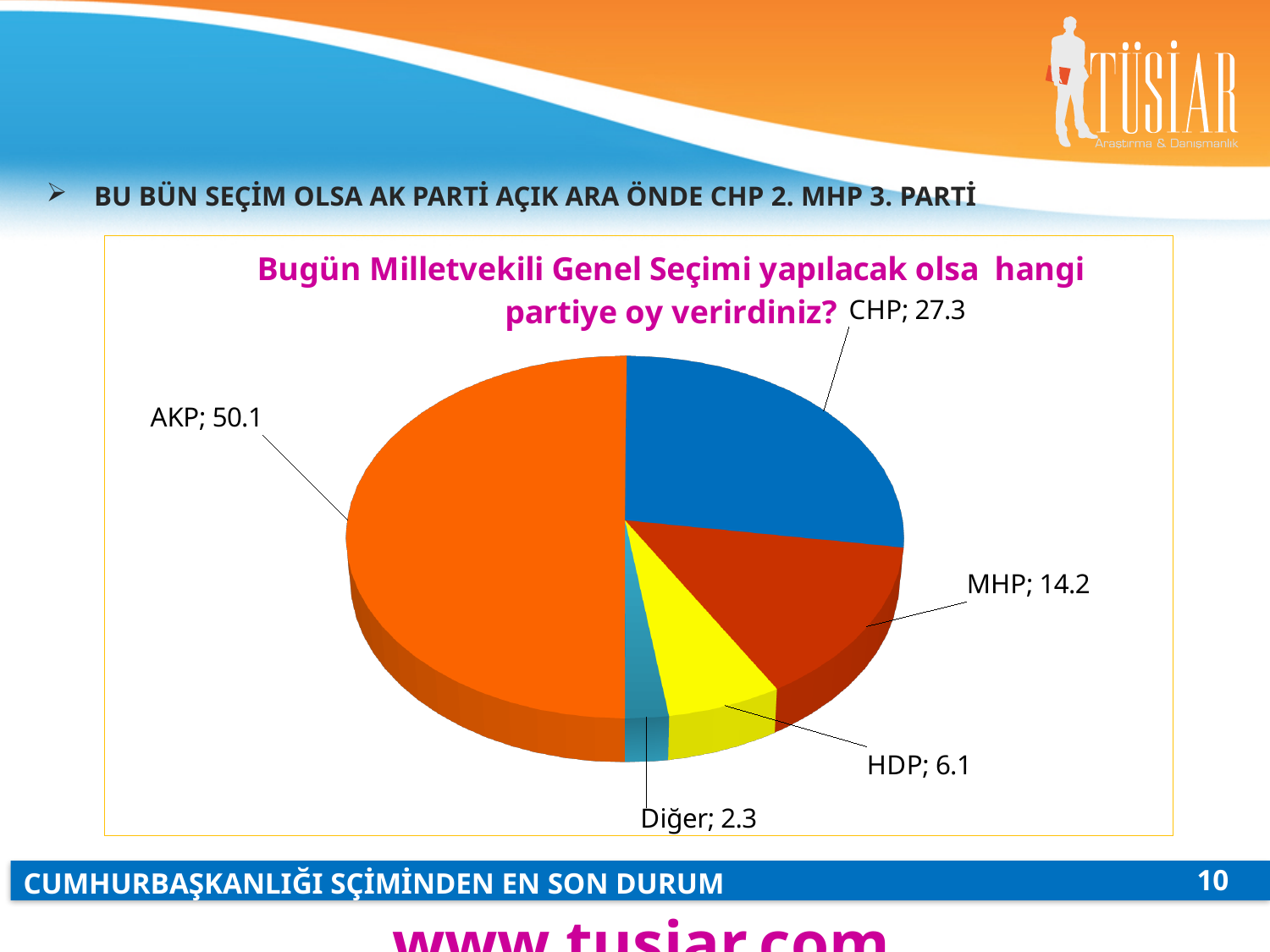
Which party has the largest slice in the pie chart? AKP Which is larger, the value for MHP or the value for HDP? MHP What type of chart is shown on the slide? Pie chart What value is shown for CHP in the pie chart? 27.3 What value is shown for MHP in the pie chart? 14.2 What value is shown for Diğer in the pie chart? 2.3 How many slices does the pie chart have? 5 Which category has the smallest slice in the pie chart? Diğer What colour is the AKP slice in the pie chart? Orange What value is shown for AKP in the pie chart? 50.1 What value is shown for HDP in the pie chart? 6.1 What is the difference between the values for AKP and CHP? 22.8